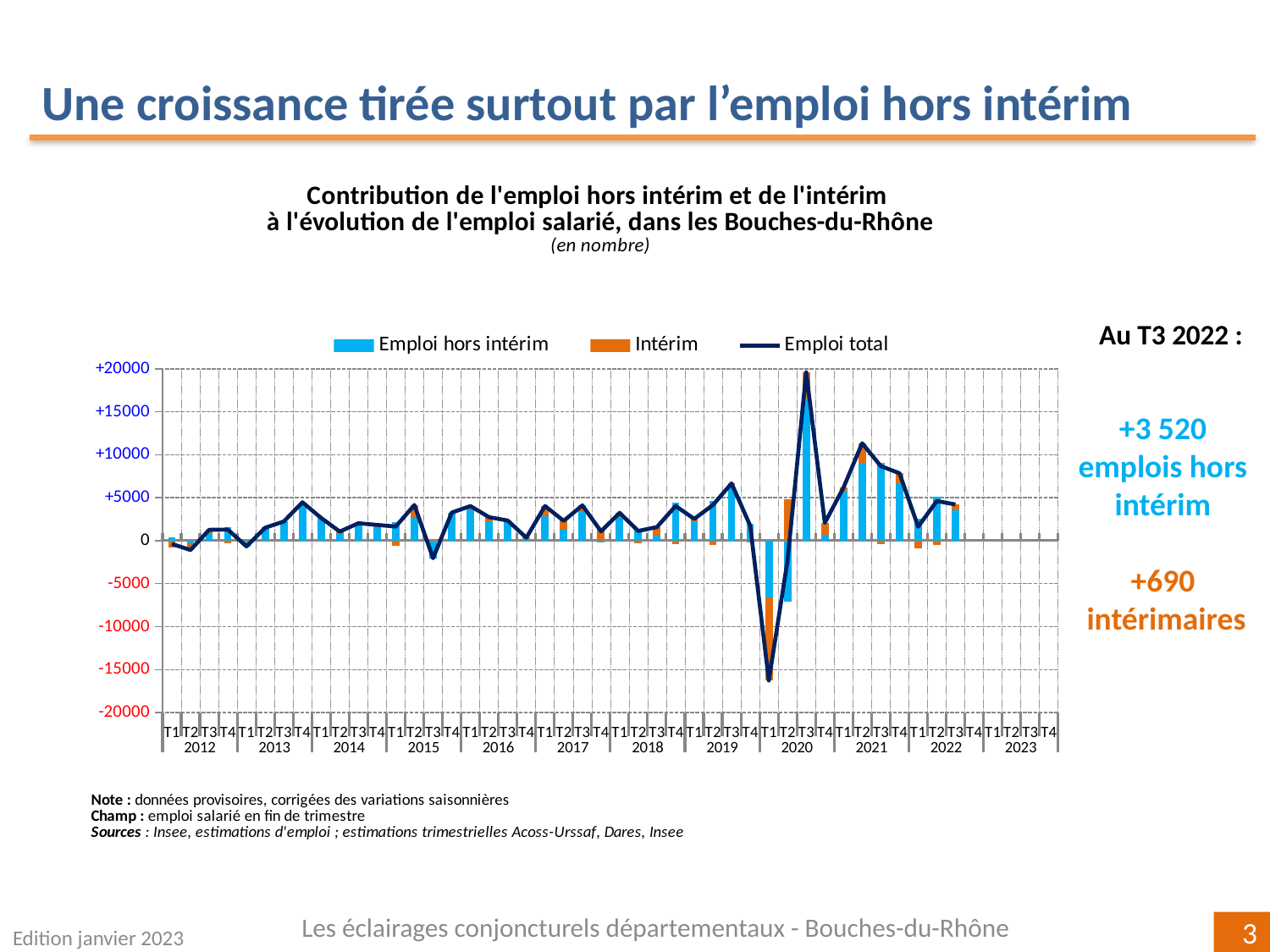
According to the slide, what is the contribution of 'intérim' at T3 2022? +690 What colour are the bars for 'Emploi hors intérim'? Light blue In which quarter does the 'Emploi total' line reach its lowest value? T1 2020 Does the 'Emploi total' line rise or fall between T3 2020 and T4 2020? Fall How many series does the legend list? 3 In which quarter does the 'Emploi total' line reach its highest value? T3 2020 Is the 'Emploi total' value at T3 2020 greater or less than 15000? greater Which series is drawn as a dark line rather than bars? Emploi total According to the slide, what is the contribution of 'emploi hors intérim' at T3 2022? +3 520 Is the 'Emploi total' value at T1 2020 greater or less than -15000? less What kind of chart is shown on the slide? A bar chart combined with a line chart Which is larger, the 'Emploi total' value at T3 2020 or at T1 2021? T3 2020